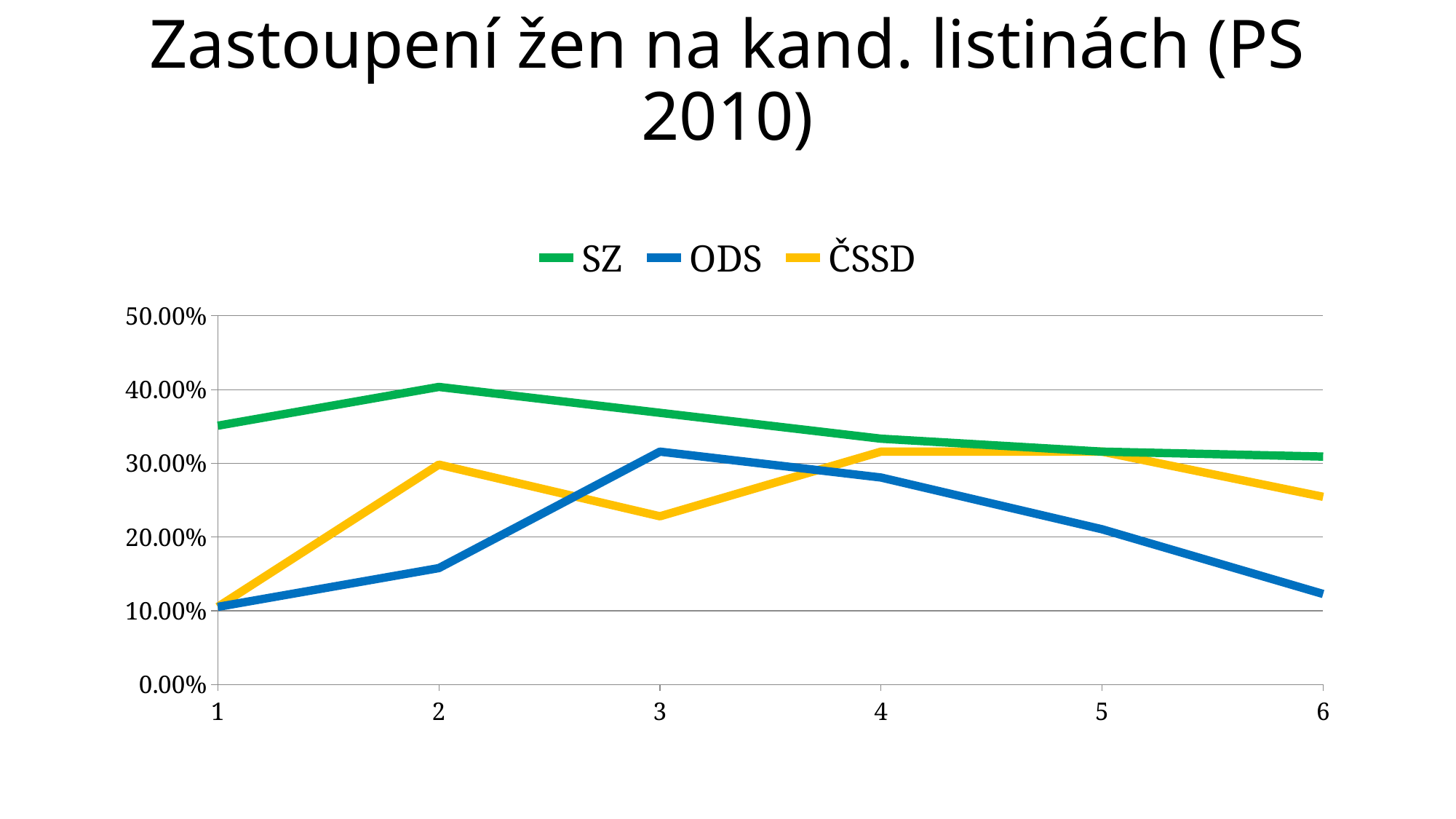
Which colour is used for the SZ series line? green At which x-axis position does the SZ series reach its highest value? 2 At which x-axis position does the ODS series reach its highest value? 3 Is the value for ODS at position 6 greater or less than 20.00%? less Is the value for SZ at position 1 greater or less than 30.00%? greater How many points are plotted along the x axis for each series? 6 Is the value for ČSSD at position 2 greater or less than 40.00%? less Do the values of the ODS series rise or fall from position 3 to position 6? fall At which x-axis position does the ČSSD series have its lowest value? 1 At position 3, which series has the larger value, ODS or ČSSD? ODS What kind of chart is shown on the slide? line chart How many series does the legend list? 3